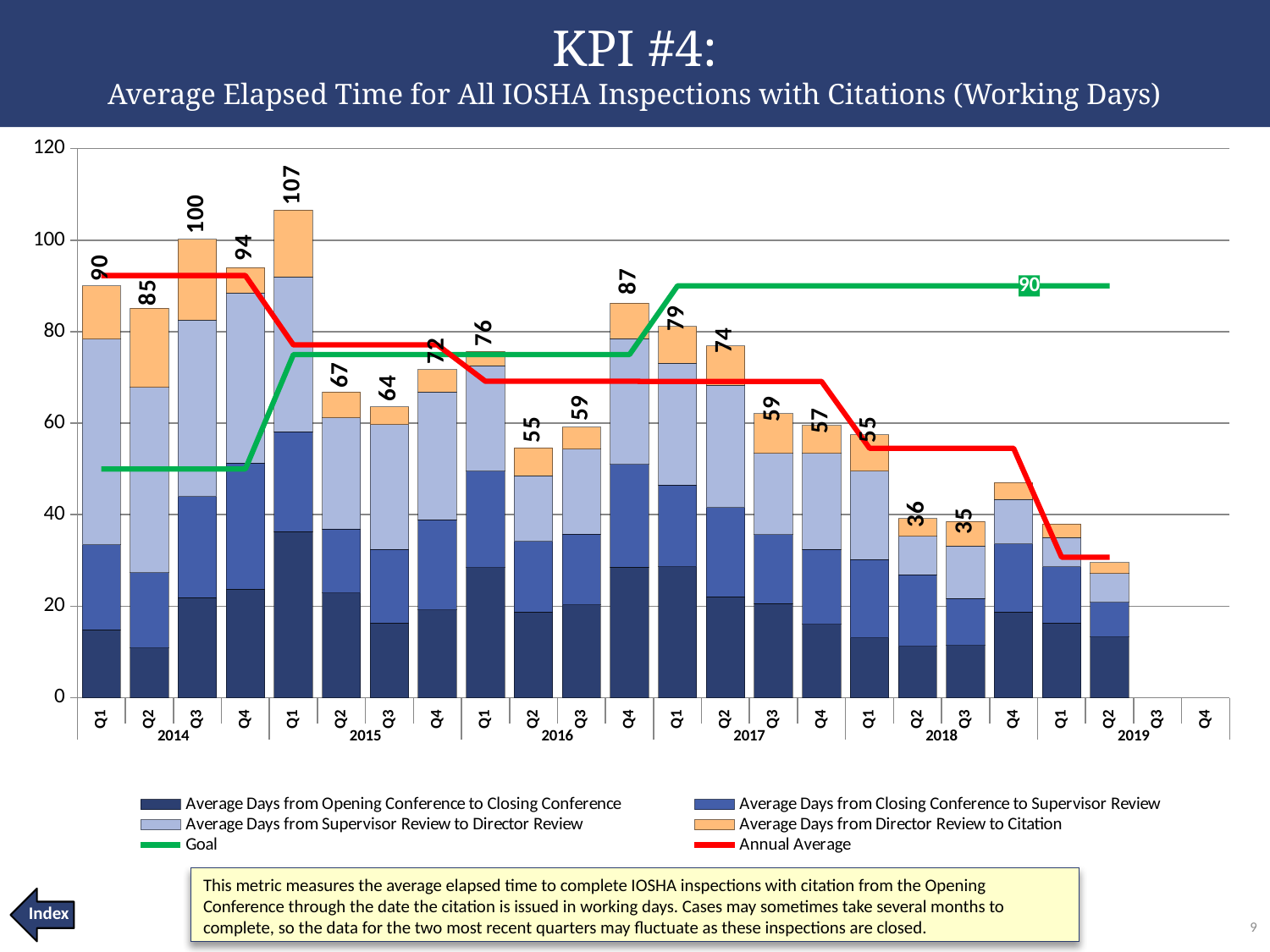
What is the total average elapsed time labeled for Q4 2016? 87 Which quarter has the highest labeled total average elapsed time? Q1 2015 Which is larger, the labeled total for Q1 2017 or Q2 2017? Q1 2017 What is the difference between the labeled totals for Q1 2016 and Q2 2016? 21 How many series does the legend list? 6 What kind of chart is shown on the slide? combination bar and line chart (stacked bars with Goal and Annual Average lines) What value is labeled on the Goal line near the end of 2018? 90 What is the difference between the labeled totals for Q3 2014 and Q2 2014? 15 What is the total average elapsed time labeled for Q2 2018? 36 Do the labeled totals rise or fall from Q1 2017 to Q3 2018? fall Is the total bar height for Q2 2019 greater or less than 40? less What is the total average elapsed time labeled for Q1 2015? 107